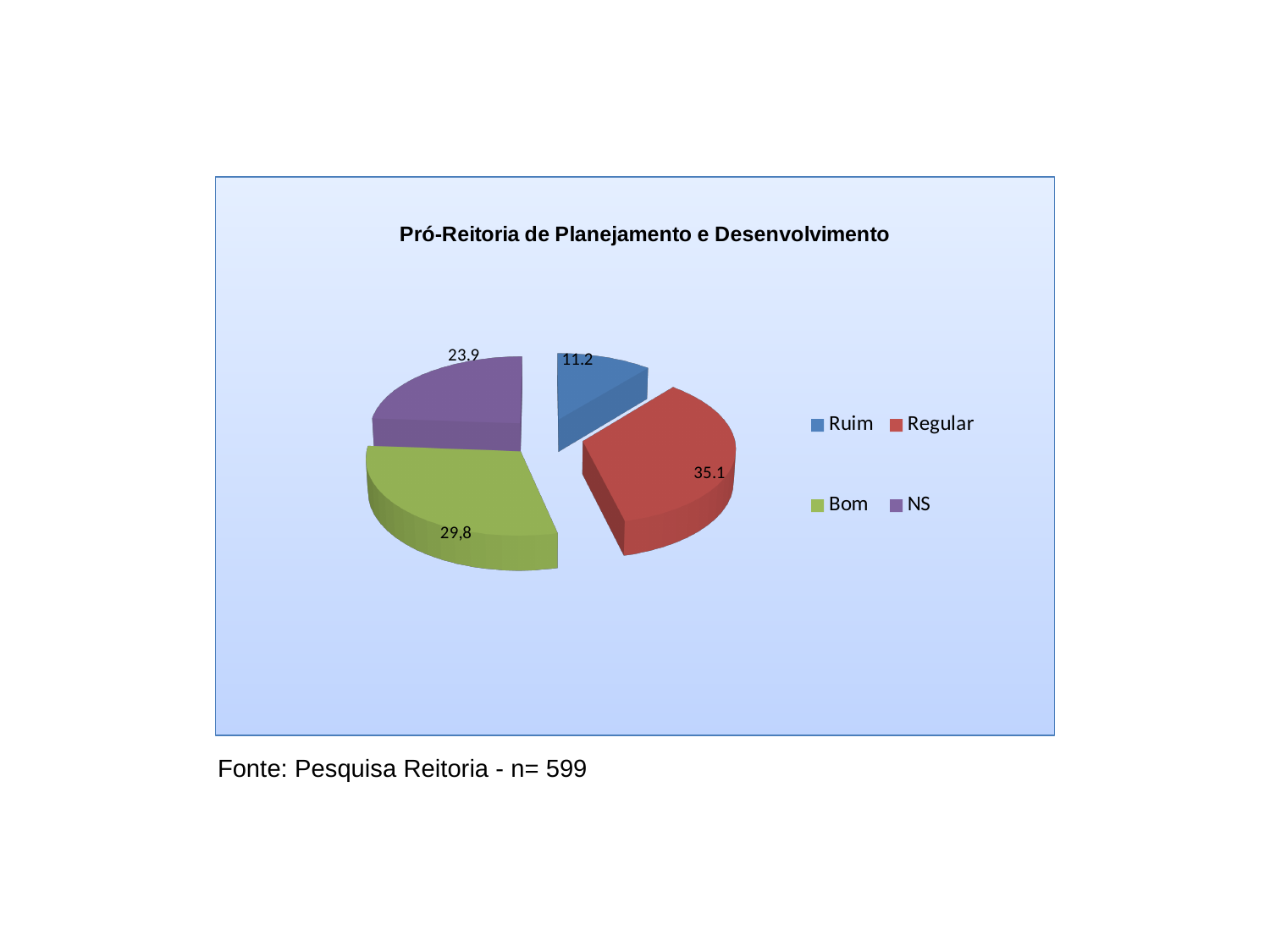
How many slices does the pie chart have? 4 What is the title of the chart? Pró-Reitoria de Planejamento e Desenvolvimento Which is larger, the value for Bom or the value for NS? Bom What is the value for NS in the pie chart? 23.9 What kind of chart is shown on the slide? Pie chart Which category has the largest slice of the pie? Regular What is the value for Bom in the pie chart? 29,8 What is the difference between the values for Regular and Ruim? 23.9 What is the value for Regular in the pie chart? 35.1 What is the difference between the values for NS and Ruim? 12.7 What is the value for Ruim in the pie chart? 11.2 Which category has the smallest slice of the pie? Ruim